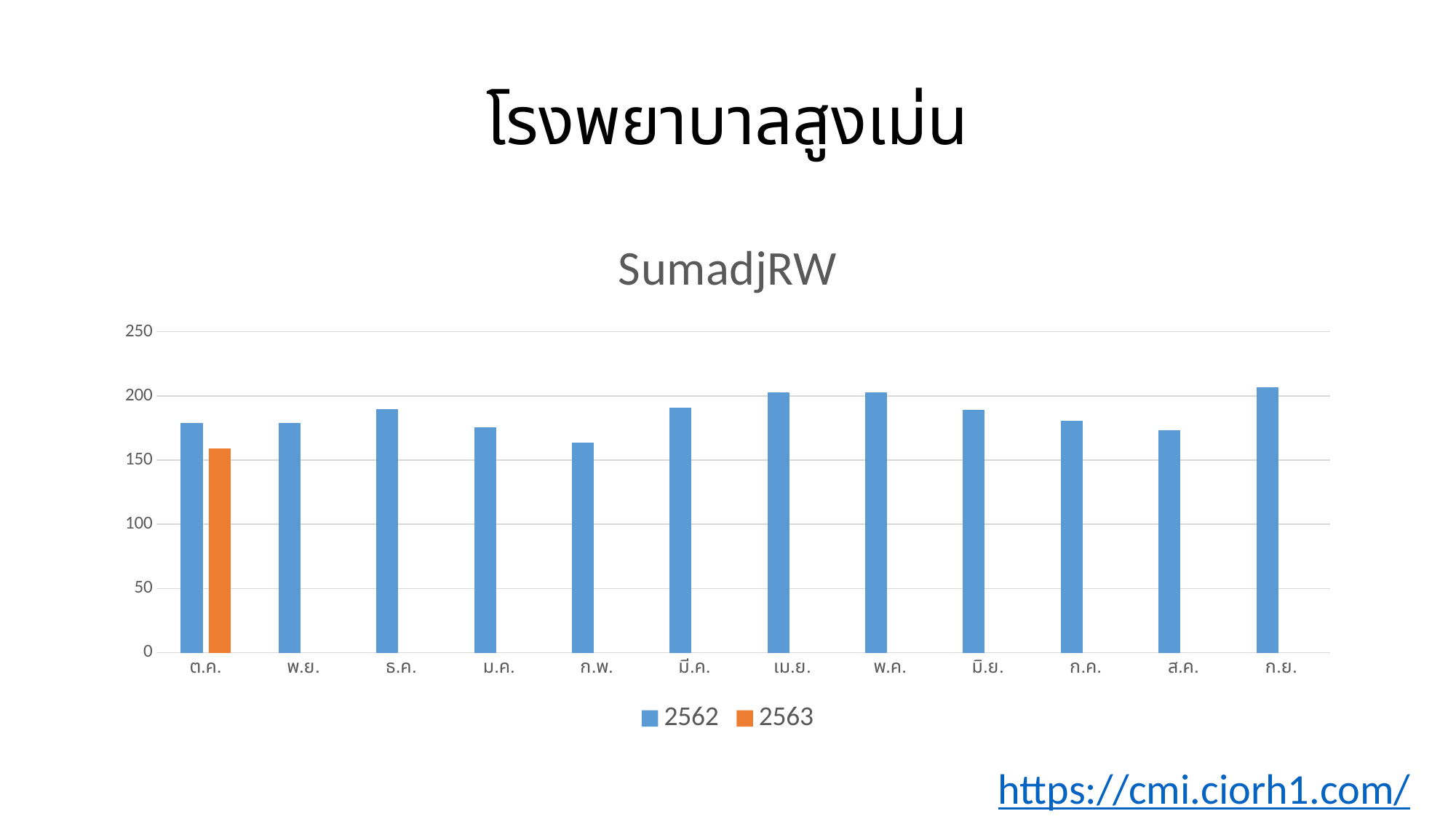
How many series does the legend list? 2 What kind of chart is shown on the slide? bar chart Is the 2562 value for ก.พ. greater or less than 200? less Which series is shown in orange? 2563 Which month has the lowest value for the 2562 series? ก.พ. For ต.ค., which series has the larger value, 2562 or 2563? 2562 Which has the larger 2562 value, ก.พ. or มี.ค.? มี.ค. How many month categories are shown on the x axis? 12 Is the 2562 value for ก.ย. greater or less than 200? greater Is the 2563 value for ต.ค. greater or less than 150? greater What is the title of the chart? SumadjRW